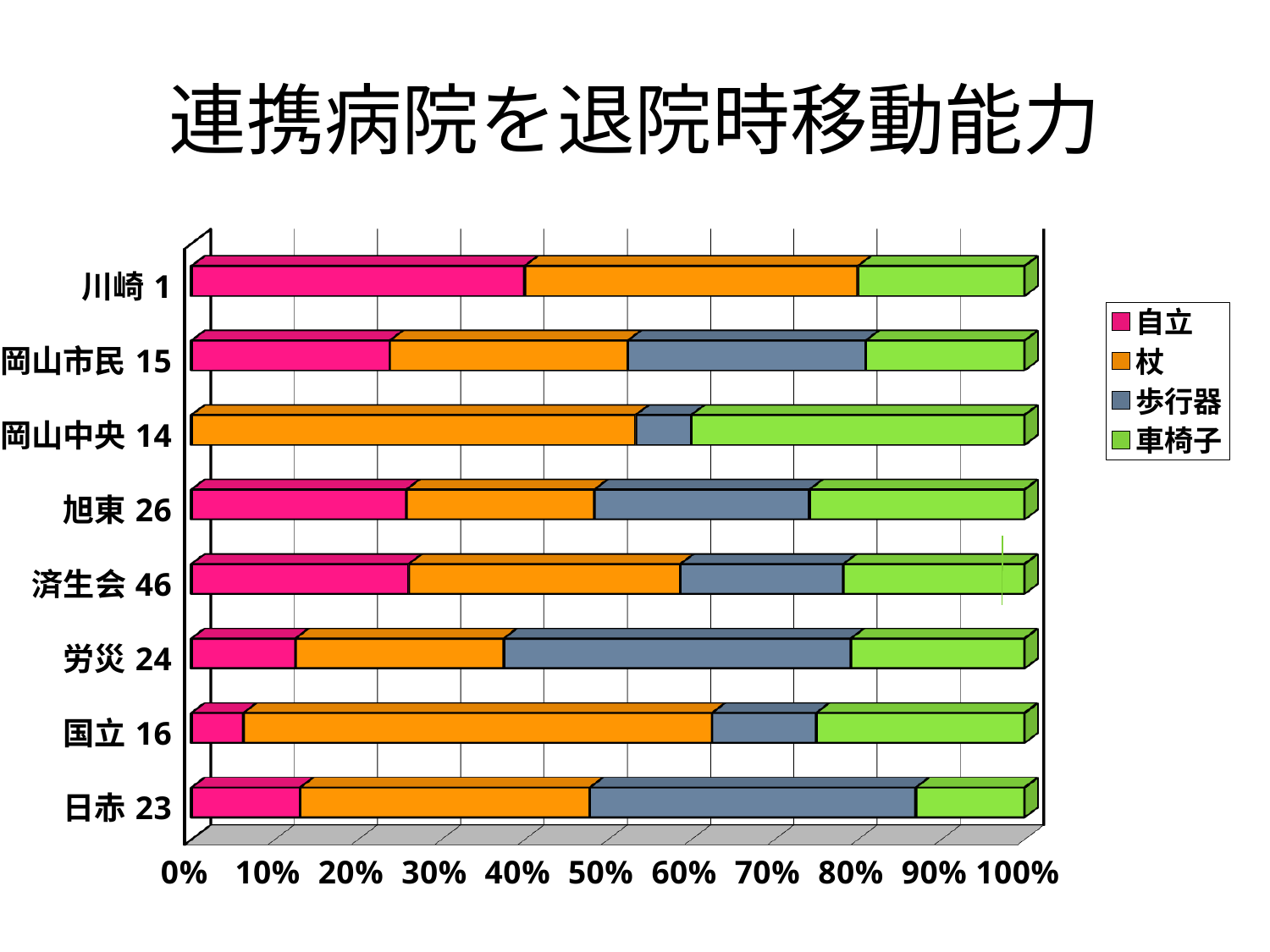
What kind of chart is shown on the slide? Stacked bar chart Which series is shown in green in the legend? 車椅子 What is the title of the chart? 連携病院を退院時移動能力 Which is larger, the 自立 share for 川崎 1 or for 国立 16? 川崎 1 Is the 車椅子 share for 岡山中央 14 greater or less than 30%? greater How many hospitals (categories) are plotted on the chart? 8 How many series does the legend list? 4 Is the 自立 share for 国立 16 greater or less than 10%? less Is the 自立 share for 川崎 1 greater or less than 30%? greater Which hospital has the largest 自立 share? 川崎 1